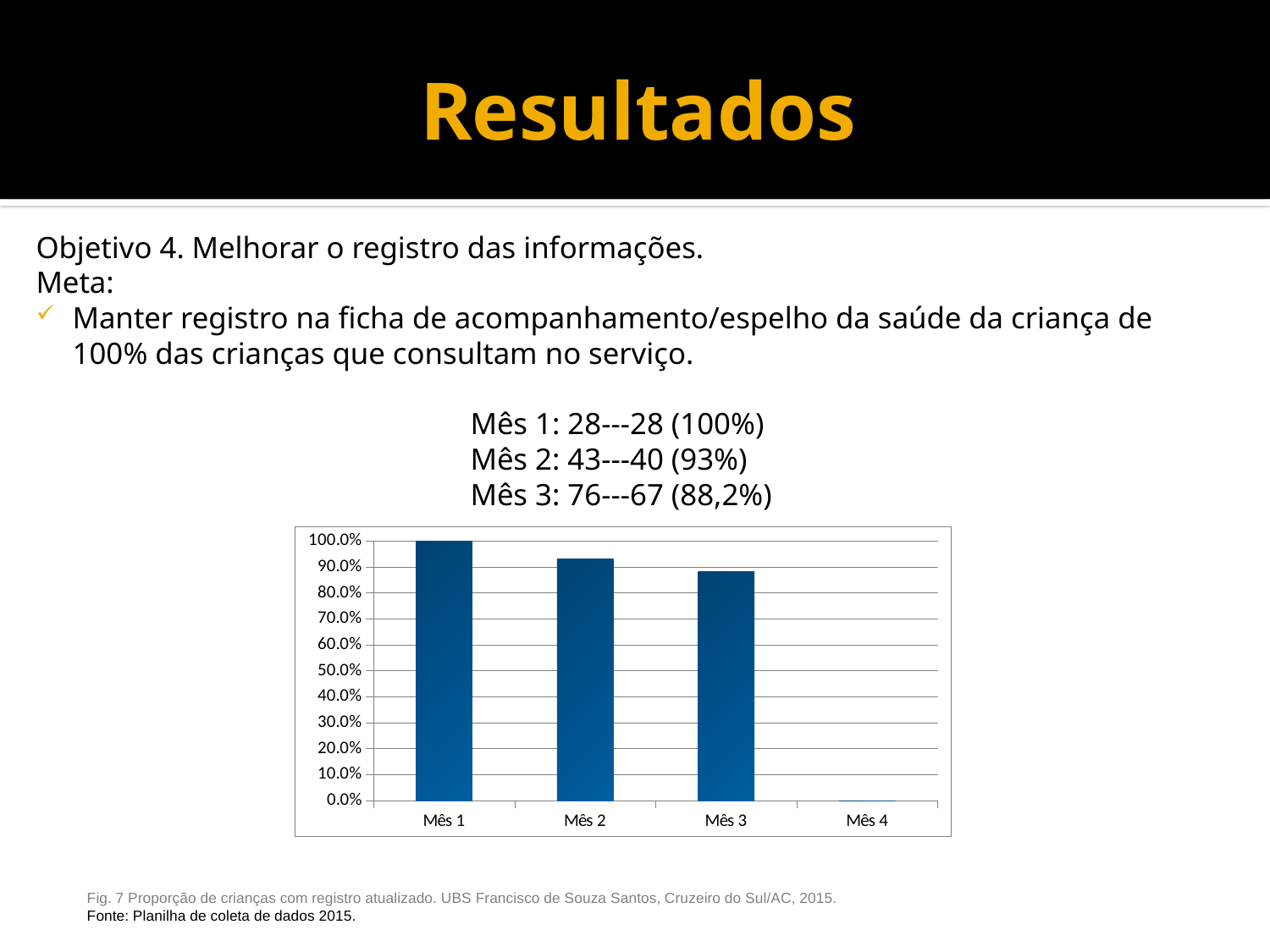
Is the value for Mês 3 greater or less than 80.0%? greater What is the value for Mês 4 in the chart? 0.0% Which month has the highest bar in the chart? Mês 1 Which month has the lowest bar in the chart? Mês 4 Which is larger, the value for Mês 2 or the value for Mês 3? Mês 2 Is the value for Mês 3 greater or less than 90.0%? less How many categories (months) are shown on the x axis of the chart? 4 What is the value for Mês 1 in the chart? 100.0% Do the bar values rise or fall from Mês 1 to Mês 4? fall Is the value for Mês 2 greater or less than 90.0%? greater What colour are the bars in the chart? blue What kind of chart is shown on the slide? bar chart